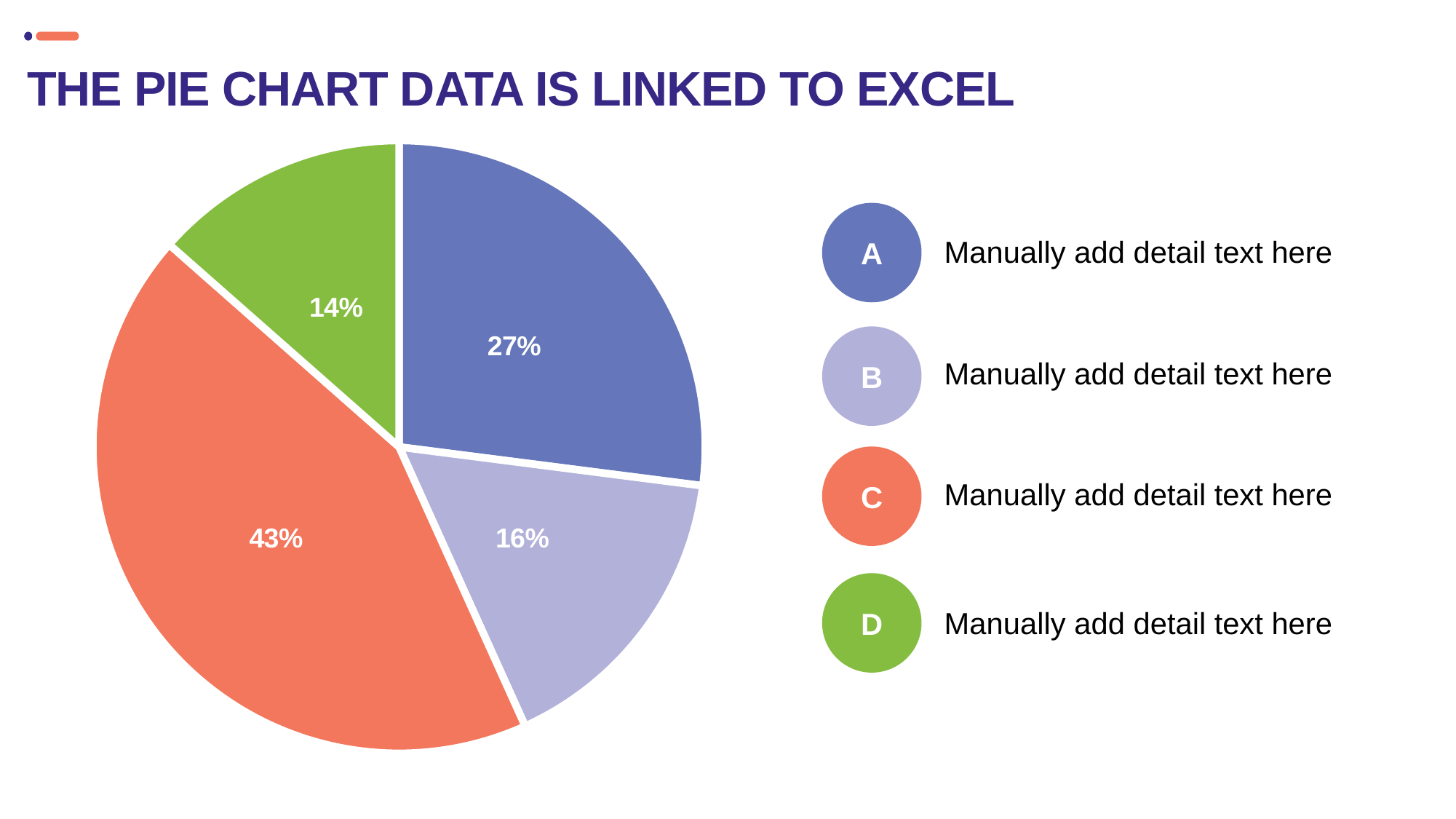
What is the title of the slide containing the pie chart? THE PIE CHART DATA IS LINKED TO EXCEL What is the difference in percentage points between slice C and slice A? 16 What is the combined share of slices A and B? 43% What percentage is shown for slice A (the dark blue slice)? 27% What kind of chart is shown on the slide? Pie chart What percentage is shown for slice D (the green slice)? 14% What percentage is shown for slice B (the light purple slice)? 16% Which slice has the smallest share of the pie? D Which is larger, slice A or slice B? A Which slice has the largest share of the pie? C What percentage is shown for slice C (the orange slice)? 43% How many slices does the pie chart have? 4